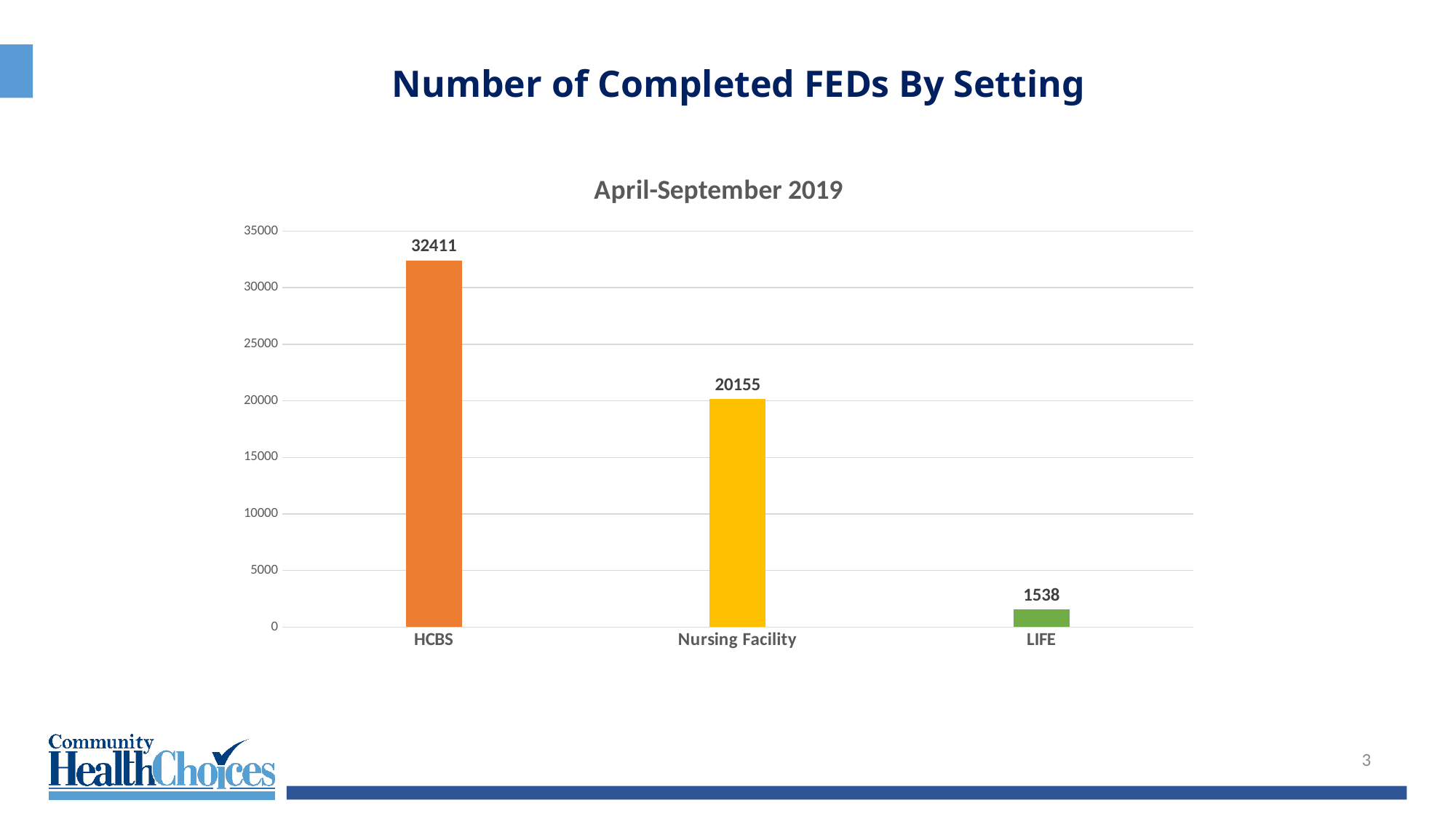
How many settings are shown on the chart? 3 Which setting has the highest number of completed FEDs? HCBS What kind of chart is shown on the slide? Bar chart Which setting has the lowest number of completed FEDs? LIFE What is the number of completed FEDs for Nursing Facility? 20155 What is the difference between the Nursing Facility and LIFE values? 18617 What is the number of completed FEDs for HCBS? 32411 What is the number of completed FEDs for LIFE? 1538 Which is larger, the value for Nursing Facility or the value for LIFE? Nursing Facility Is the value for HCBS greater or less than 30000? greater What is the difference between the HCBS and Nursing Facility values? 12256 What time period does the chart subtitle indicate? April-September 2019